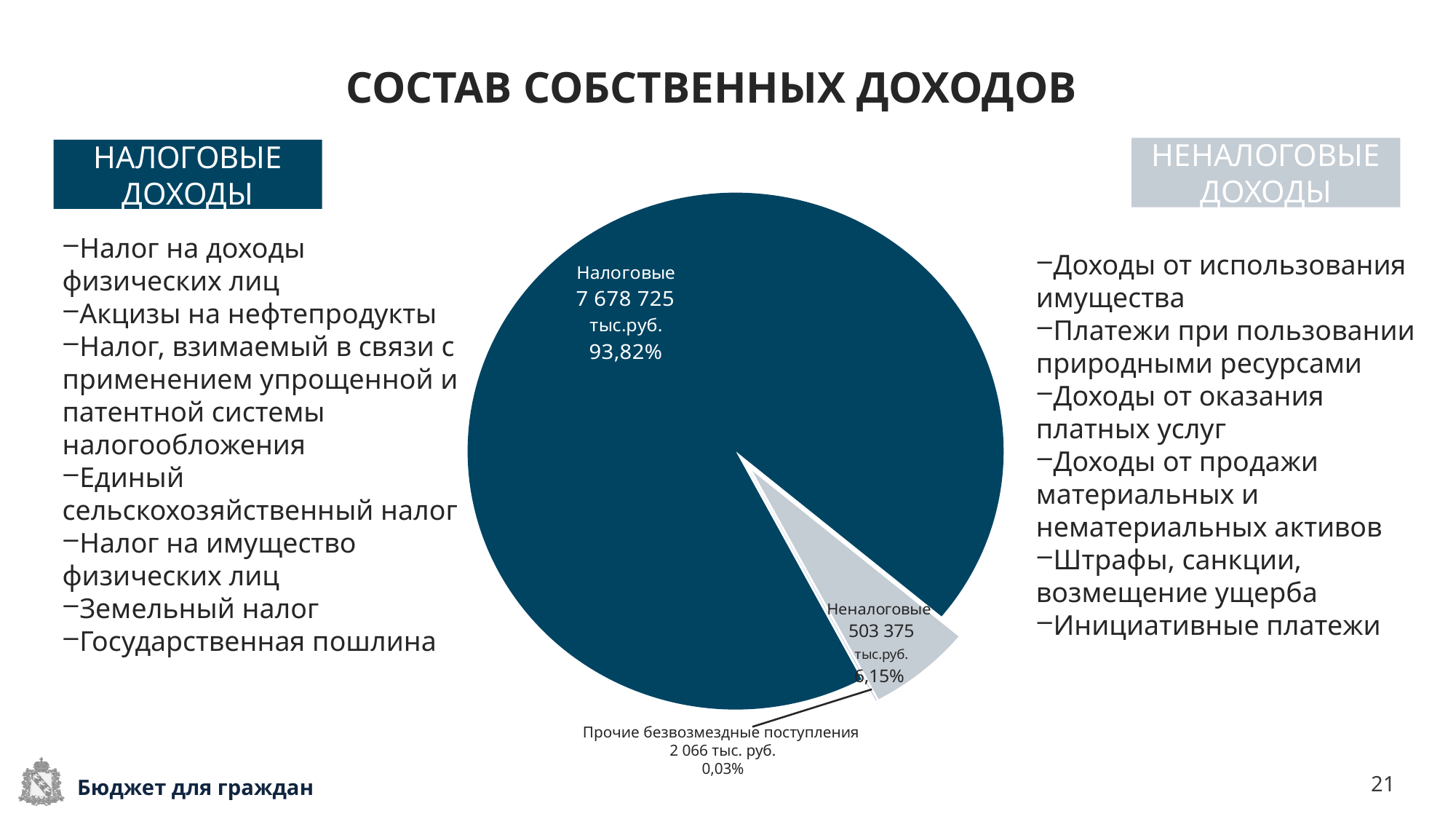
What is the value shown for the Налоговые slice? 7 678 725 тыс.руб. What is the value shown for the Неналоговые slice? 503 375 тыс.руб. What share of the pie does the Налоговые slice represent? 93,82% Which slice of the pie chart is the smallest? Прочие безвозмездные поступления What share of the pie does Прочие безвозмездные поступления represent? 0,03% How many slices does the pie chart have? 3 Which slice of the pie chart is the largest? Налоговые Which is larger, the Неналоговые slice or the Прочие безвозмездные поступления slice? Неналоговые What kind of chart is shown on the slide? Pie chart What is the difference in percentage points between the Налоговые share and the Неналоговые share? 87,67 What is the value shown for Прочие безвозмездные поступления? 2 066 тыс. руб. What share of the pie does the Неналоговые slice represent? 6,15%